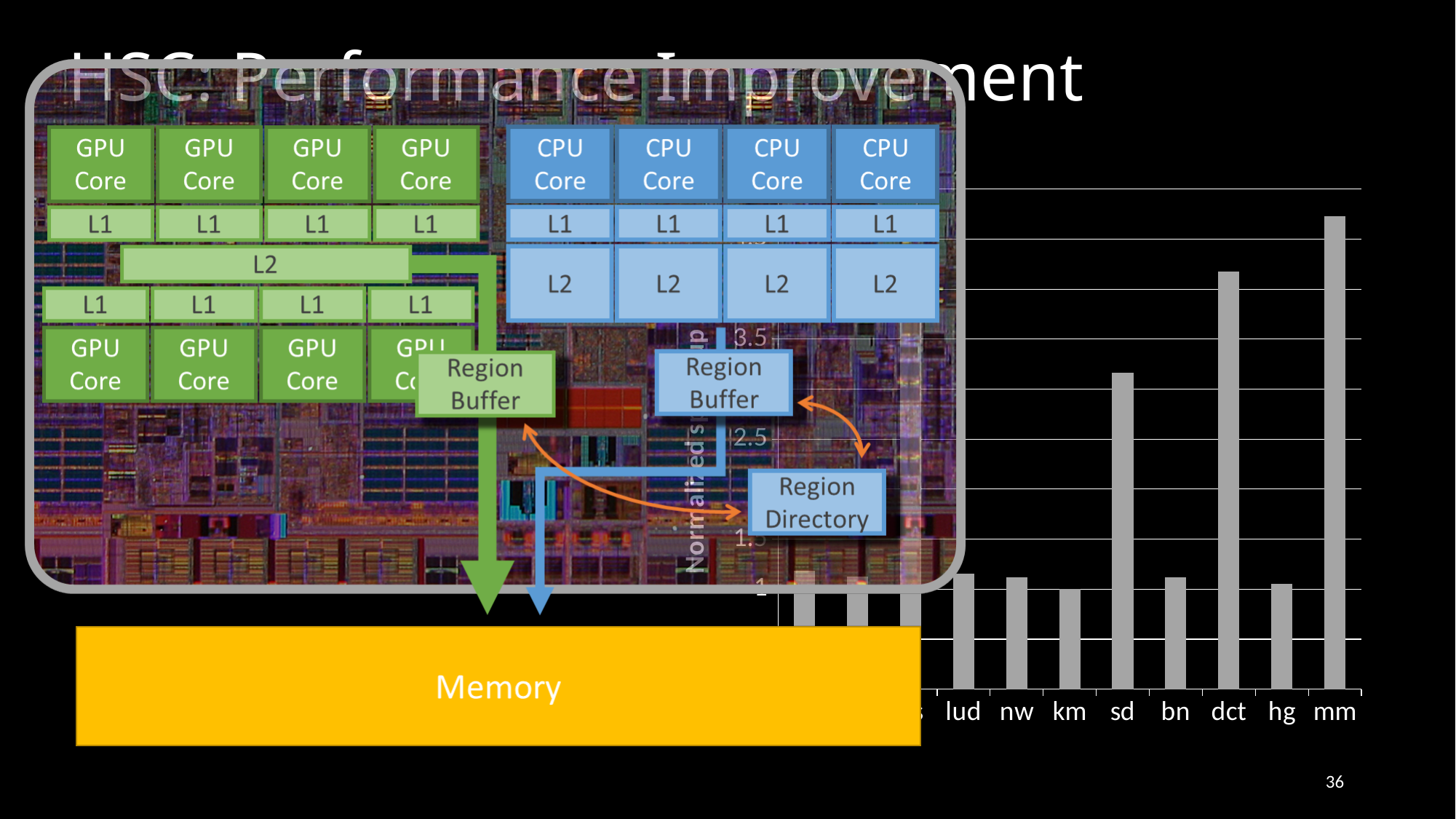
What kind of chart is shown on the right side of the slide? bar chart Which has the larger value, dct or sd? dct Is the value for dct greater or less than 3.5? greater Is the value for sd greater or less than 3.5? less Is the value for km greater or less than 1.5? less Which has the larger value, mm or dct? mm What colour are the bars in the chart? grey Which category has the highest bar in the chart? mm Which has the larger value, sd or bn? sd